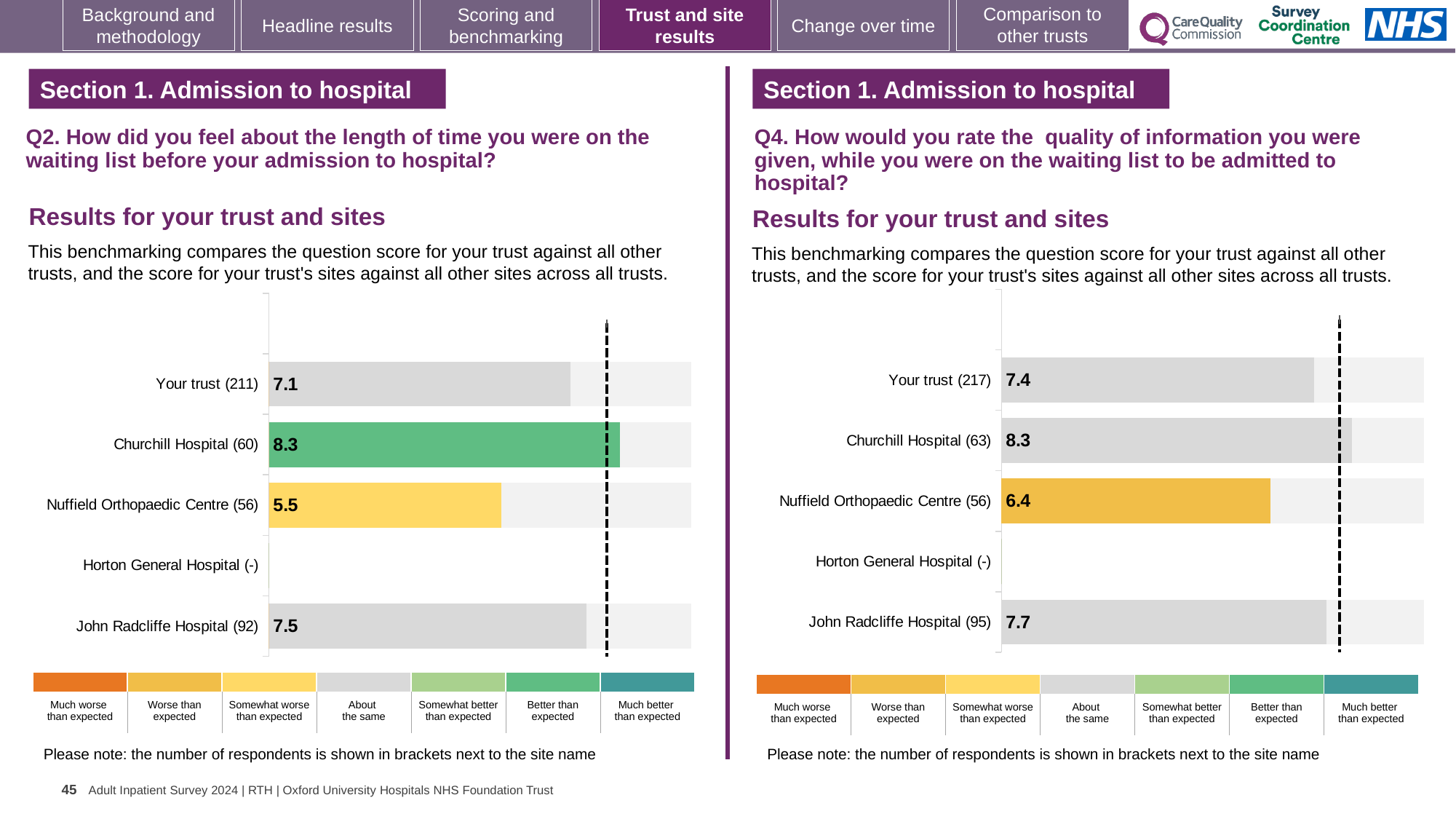
In the Q2 chart on the left, which site has the lowest score? Nuffield Orthopaedic Centre How many categories are listed on the y axis of the Q4 chart on the right? 5 In the Q2 chart on the left, what is the score for Churchill Hospital? 8.3 In the Q4 chart on the right, which site has the highest score? Churchill Hospital In the Q4 chart on the right, what is the difference between the scores for Your trust and Nuffield Orthopaedic Centre? 1.0 What kind of chart is the Q2 chart on the left? Bar chart In the Q2 chart on the left, which has the higher score, Your trust or John Radcliffe Hospital? John Radcliffe Hospital In the Q2 chart on the left, what is the difference between the scores for Churchill Hospital and Nuffield Orthopaedic Centre? 2.8 In the Q2 chart on the left, what is the score for Nuffield Orthopaedic Centre? 5.5 In the Q2 chart on the left, what is the score for Your trust? 7.1 In the Q4 chart on the right, what is the score for John Radcliffe Hospital? 7.7 In the Q4 chart on the right, what is the score for Nuffield Orthopaedic Centre? 6.4